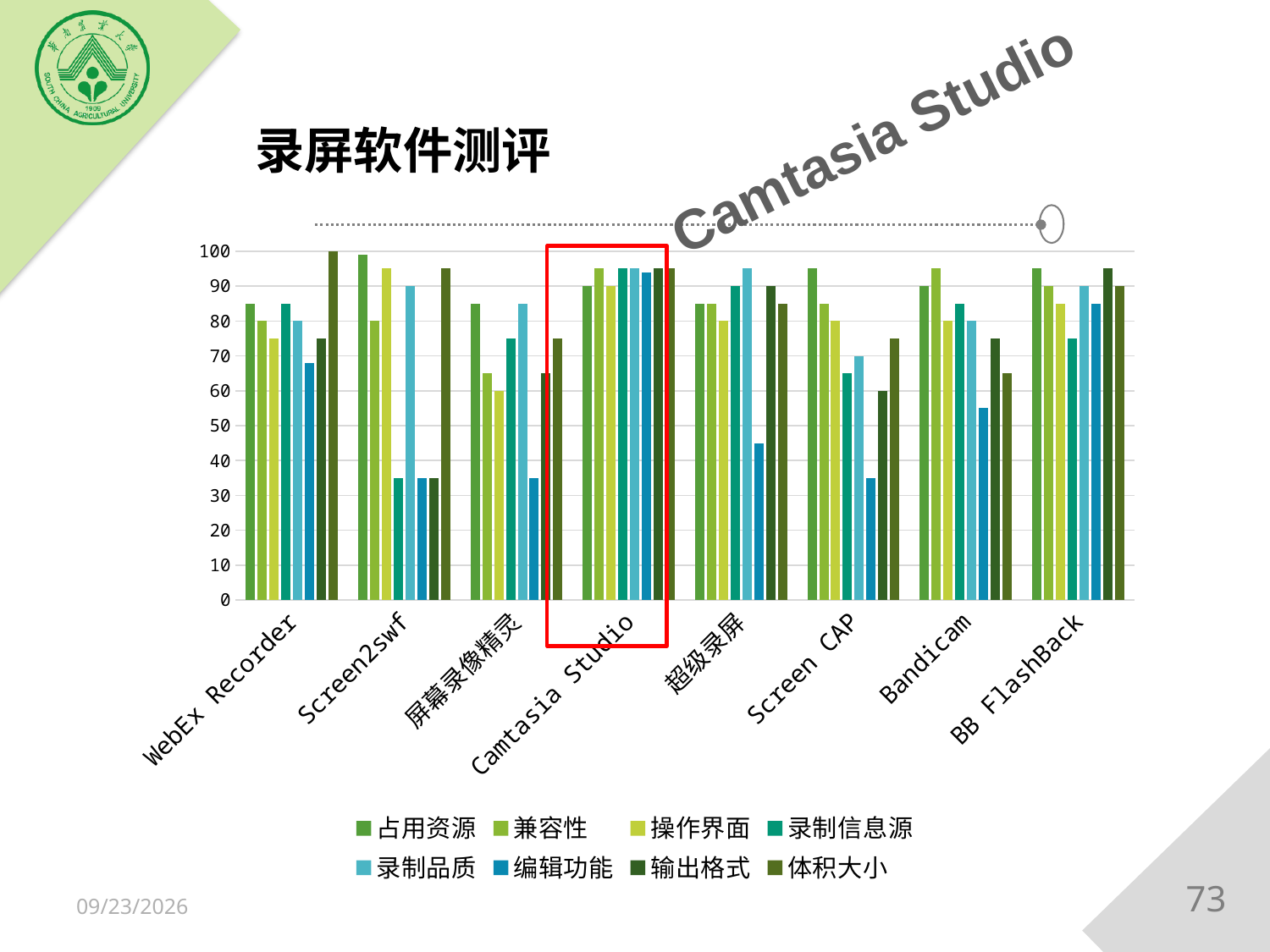
How many series does the chart's legend list? 8 Which series has the highest value for WebEx Recorder? 体积大小 Which category on the chart is highlighted with a red box? Camtasia Studio Which is larger: 输出格式 for WebEx Recorder or 输出格式 for Screen2swf? WebEx Recorder What is the value of 输出格式 for Screen CAP? 60 Is the value of 录制信息源 for Screen2swf greater or less than 50? less What is the value of 录制品质 for Screen2swf? 90 What kind of chart is shown on the slide? bar chart How many software products (categories) are shown on the x axis of the chart? 8 Which series has the lowest value for 超级录屏? 编辑功能